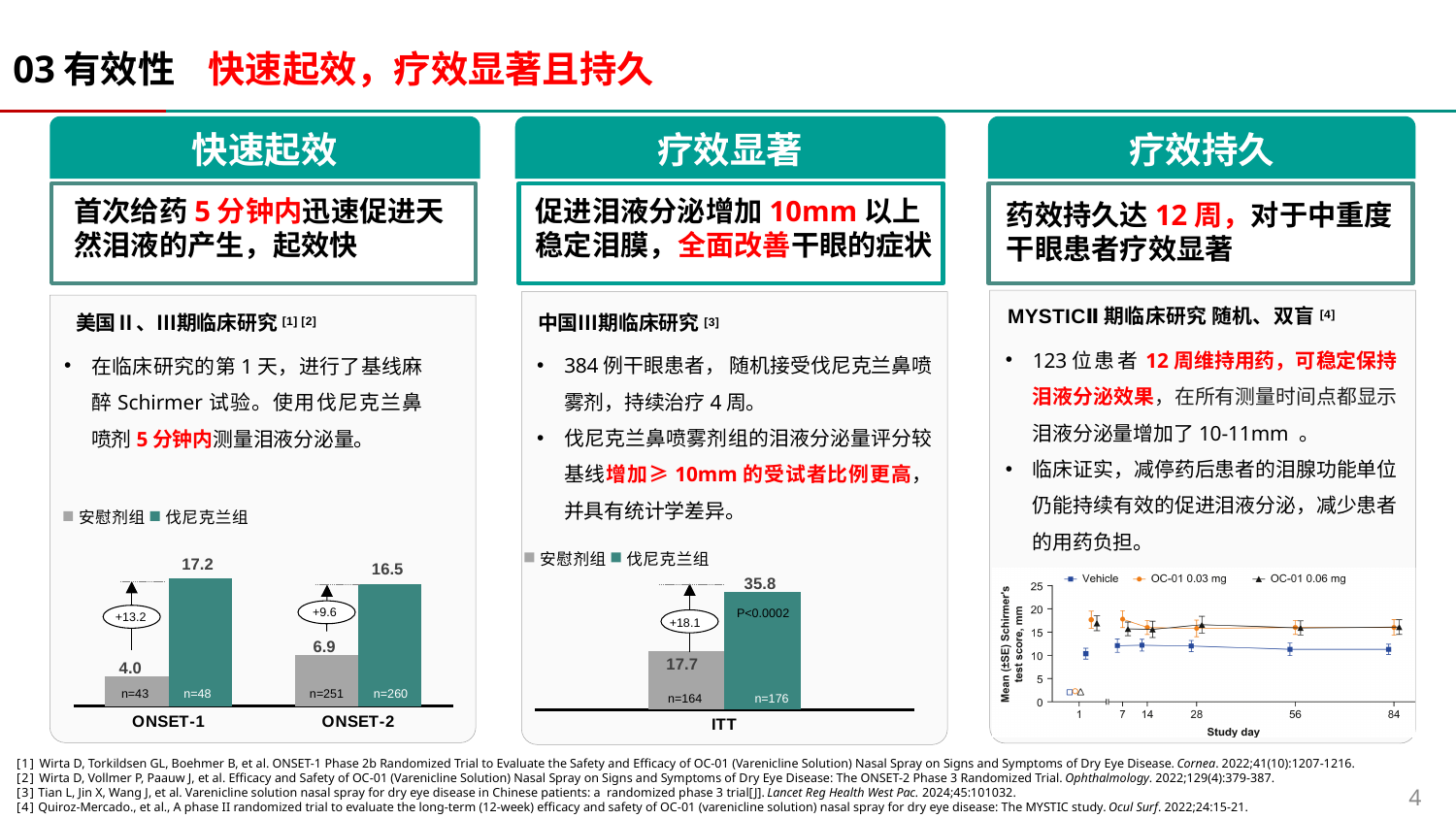
In the left bar chart, how many series does the legend list? 2 What kind of chart is shown in the right panel (MYSTIC study)? line chart In the right line chart, how many series does the legend list? 3 In the middle bar chart (中国III期临床研究), what is the value for 伐尼克兰组 in ITT? 35.8 In the left bar chart, what is the difference between 伐尼克兰组 and 安慰剂组 in ONSET-1? 13.2 In the right line chart, is the value for Vehicle at study day 84 greater or less than 15? less In the middle bar chart, what is the difference between 伐尼克兰组 and 安慰剂组 in ITT? 18.1 In the middle bar chart, what P value is shown? P<0.0002 In the left bar chart, what is the value for 安慰剂组 in ONSET-2? 6.9 In the left bar chart, which group has the higher value in ONSET-2, 安慰剂组 or 伐尼克兰组? 伐尼克兰组 In the left bar chart, what is the sample size (n) for 伐尼克兰组 in ONSET-2? n=260 In the left bar chart (美国 II、III期临床研究), what is the value for 伐尼克兰组 in ONSET-1? 17.2